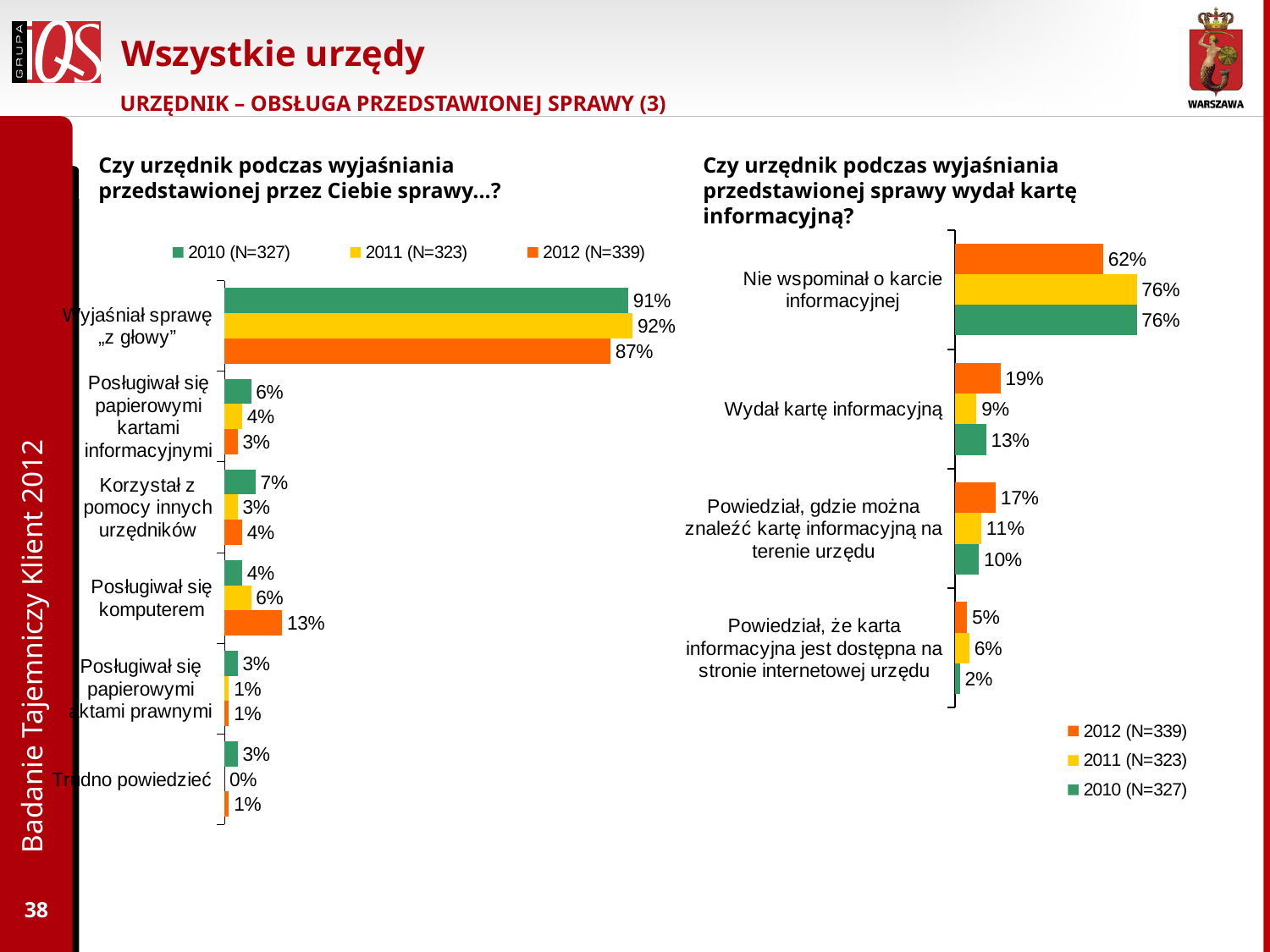
In the right chart, which category has the lowest value for 2010 (N=327)? Powiedział, że karta informacyjna jest dostępna na stronie internetowej urzędu In the left chart, what is the 2012 (N=339) value for "Posługiwał się komputerem"? 13% In the left chart, for "Korzystał z pomocy innych urzędników", which year has the larger value: 2010 or 2011? 2010 In the left chart, how many categories are shown? 6 In the right chart ("Czy urzędnik podczas wyjaśniania przedstawionej sprawy wydał kartę informacyjną?"), what is the 2012 (N=339) value for "Nie wspominał o karcie informacyjnej"? 62% In the left chart, how many series does the legend list? 3 In the left chart ("Czy urzędnik podczas wyjaśniania przedstawionej przez Ciebie sprawy...?"), what is the 2011 (N=323) value for "Wyjaśniał sprawę „z głowy”"? 92% In the right chart, what is the difference between the 2012 and 2010 values for "Powiedział, gdzie można znaleźć kartę informacyjną na terenie urzędu"? 7 percentage points In the left chart, what is the difference between the 2011 and 2012 values for "Wyjaśniał sprawę „z głowy”"? 5 percentage points What type of chart is the right chart? Bar chart In the right chart, what is the 2011 (N=323) value for "Wydał kartę informacyjną"? 9% In the left chart, which category has the highest value for 2010 (N=327)? Wyjaśniał sprawę „z głowy”